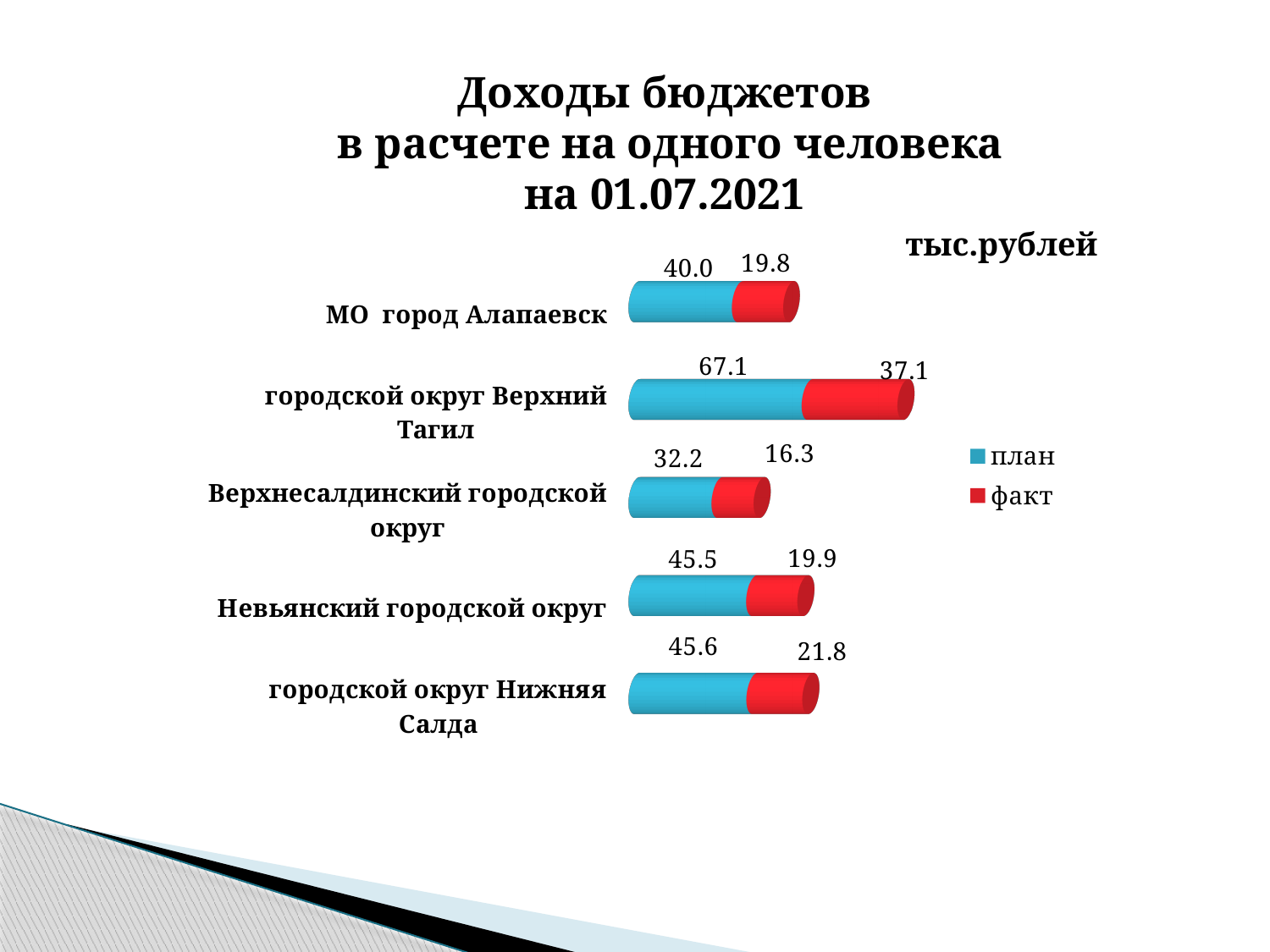
What is the факт value for городской округ Верхний Тагил? 37.1 How many series does the legend list? 2 What is the difference between the план and факт values for городской округ Нижняя Салда? 23.8 What unit is indicated for the values in the chart? тыс.рублей What kind of chart is shown on the slide? bar chart What is the план value for МО город Алапаевск? 40.0 How many categories are shown in the chart? 5 Which category has the lowest факт value? Верхнесалдинский городской округ Which category has the highest план value? городской округ Верхний Тагил What is the факт value for Верхнесалдинский городской округ? 16.3 What is the план value for Невьянский городской округ? 45.5 Which is larger, the факт value for МО город Алапаевск or the факт value for городской округ Нижняя Салда? городской округ Нижняя Салда